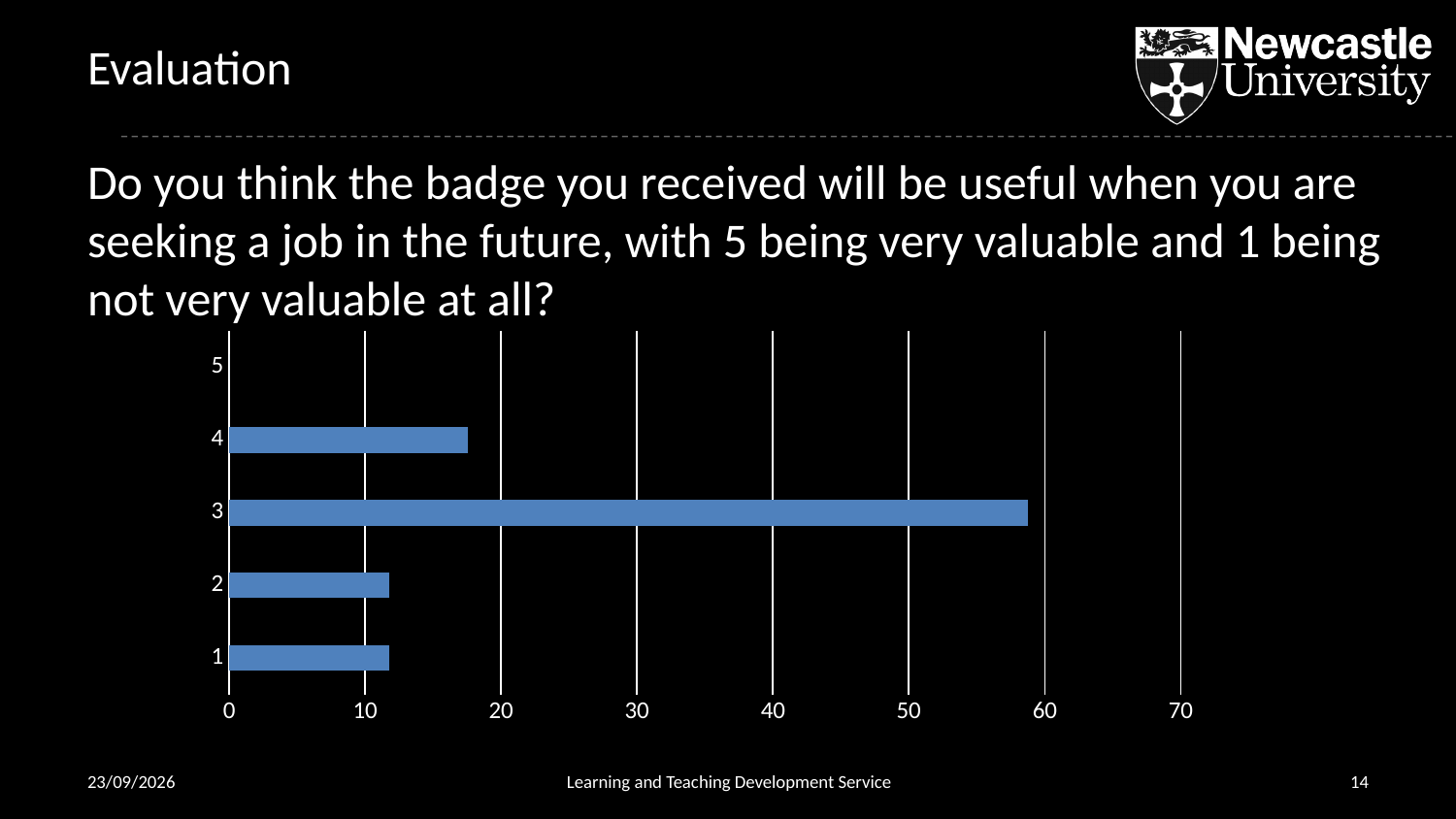
What kind of chart is shown on the slide? bar chart Which rating category has the longest bar? 3 Is the value for rating 2 greater or less than 20? less Is the value for rating 3 greater or less than 50? greater Is the value for rating 4 greater or less than 10? greater How many rating categories are shown on the vertical axis of the chart? 5 Which rating category has no visible bar? 5 Which has the larger value, rating 3 or rating 4? 3 What is the highest value shown on the horizontal axis of the chart? 70 Which has the larger value, rating 4 or rating 2? 4